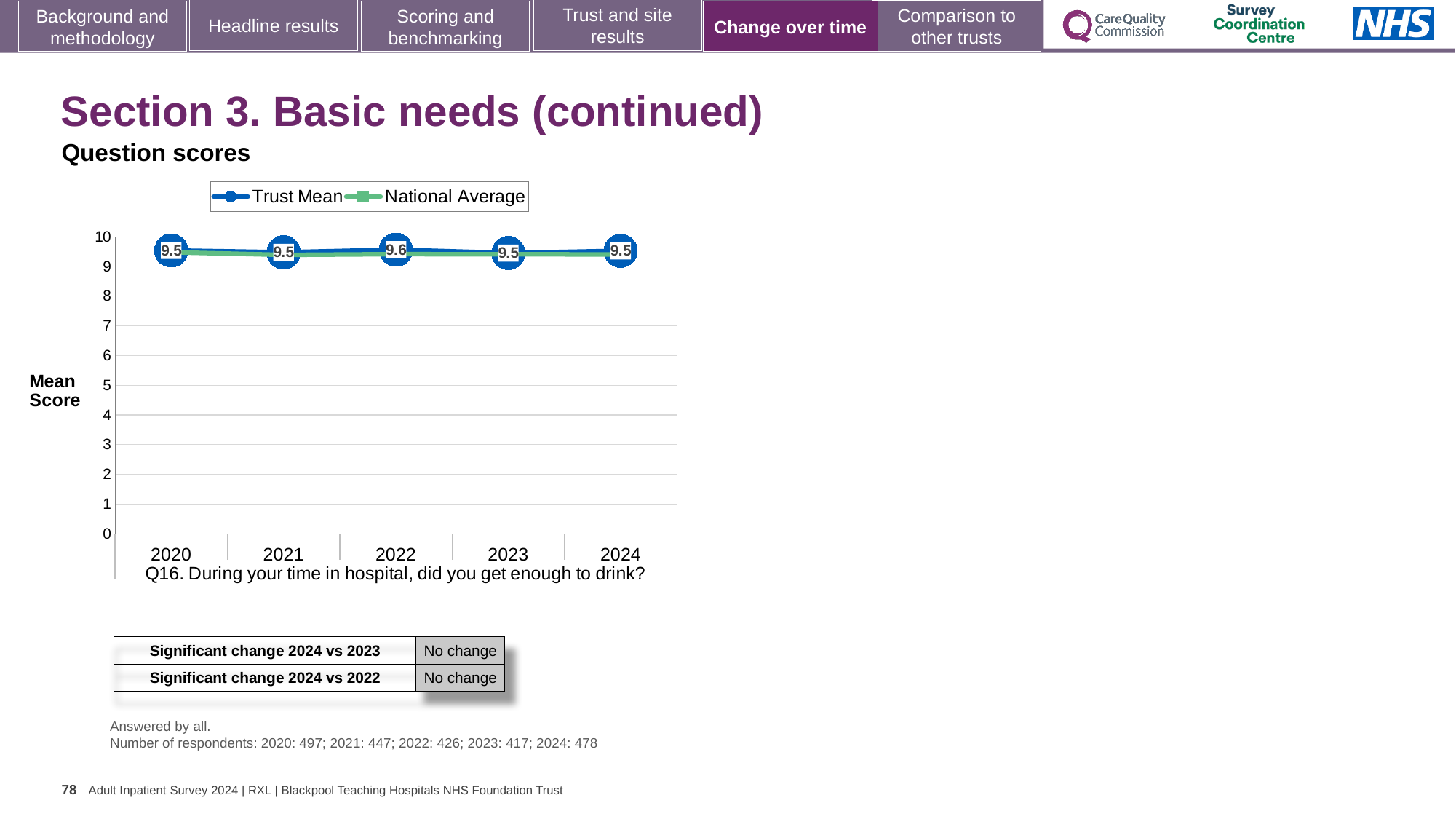
What is the Trust Mean score for 2024? 9.5 Which survey question does the chart show scores for? Q16. During your time in hospital, did you get enough to drink? How many series does the legend list? 2 What is the Trust Mean score for 2020? 9.5 What kind of chart is shown on the slide? Line chart Which is larger, the Trust Mean score for 2022 or for 2021? 2022 What are the two series named in the legend? Trust Mean and National Average What is the Trust Mean score for 2022? 9.6 What is the difference between the Trust Mean scores for 2022 and 2023? 0.1 In which year is the Trust Mean score highest? 2022 Is the National Average value for 2024 greater or less than 9? greater How many years are plotted on the x axis? 5